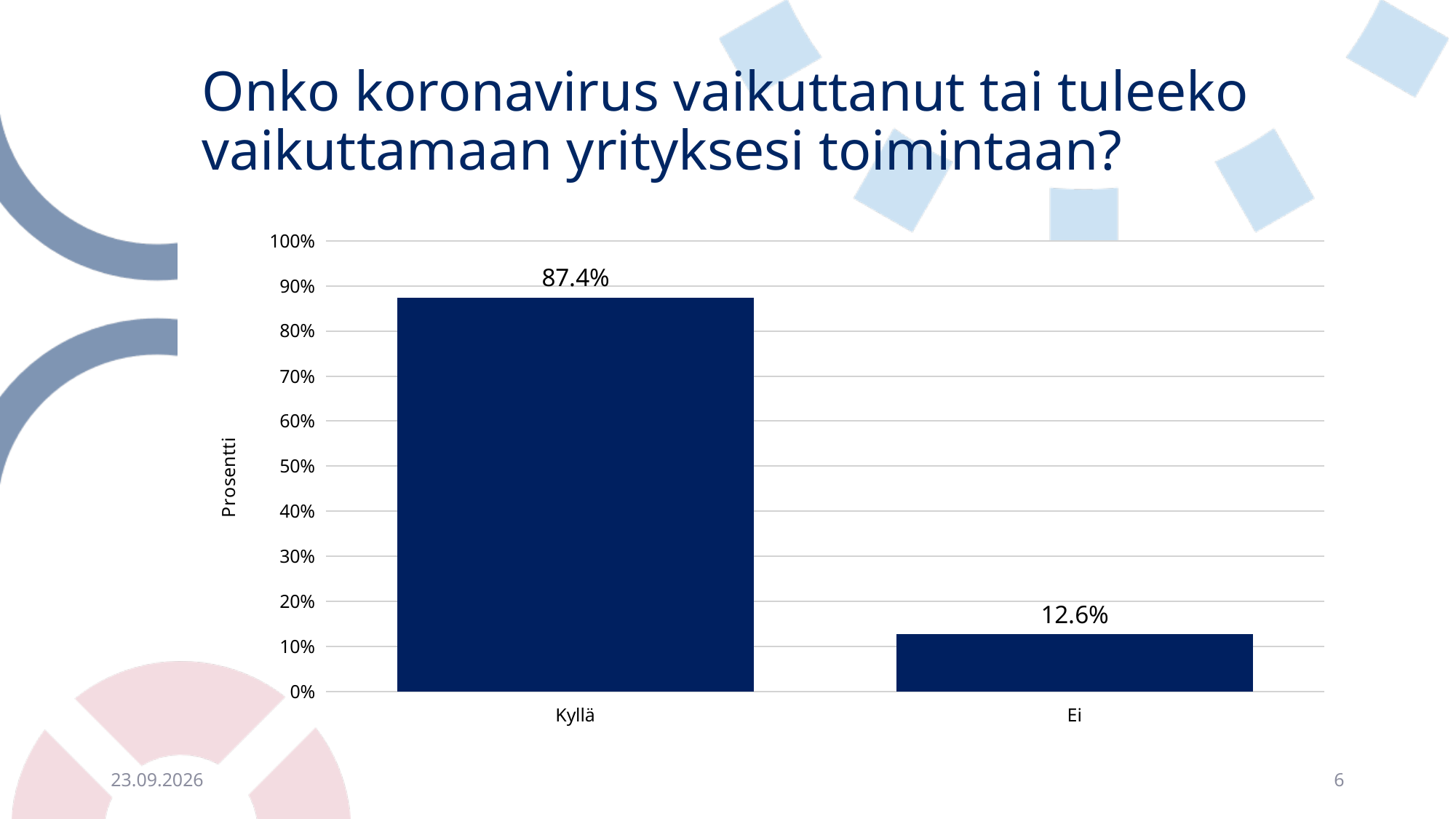
Is the value for Kyllä greater or less than 80%? greater What is the label of the vertical axis? Prosentti What is the difference between the values for Kyllä and Ei? 74.8% What is the value for Kyllä? 87.4% What is the total of the values for Kyllä and Ei? 100% Which category has the highest value? Kyllä How many categories are shown on the x axis? 2 What is the value for Ei? 12.6% Which is larger, the value for Kyllä or the value for Ei? Kyllä Which category has the lowest value? Ei What kind of chart is shown on the slide? bar chart Is the value for Ei greater or less than 20%? less